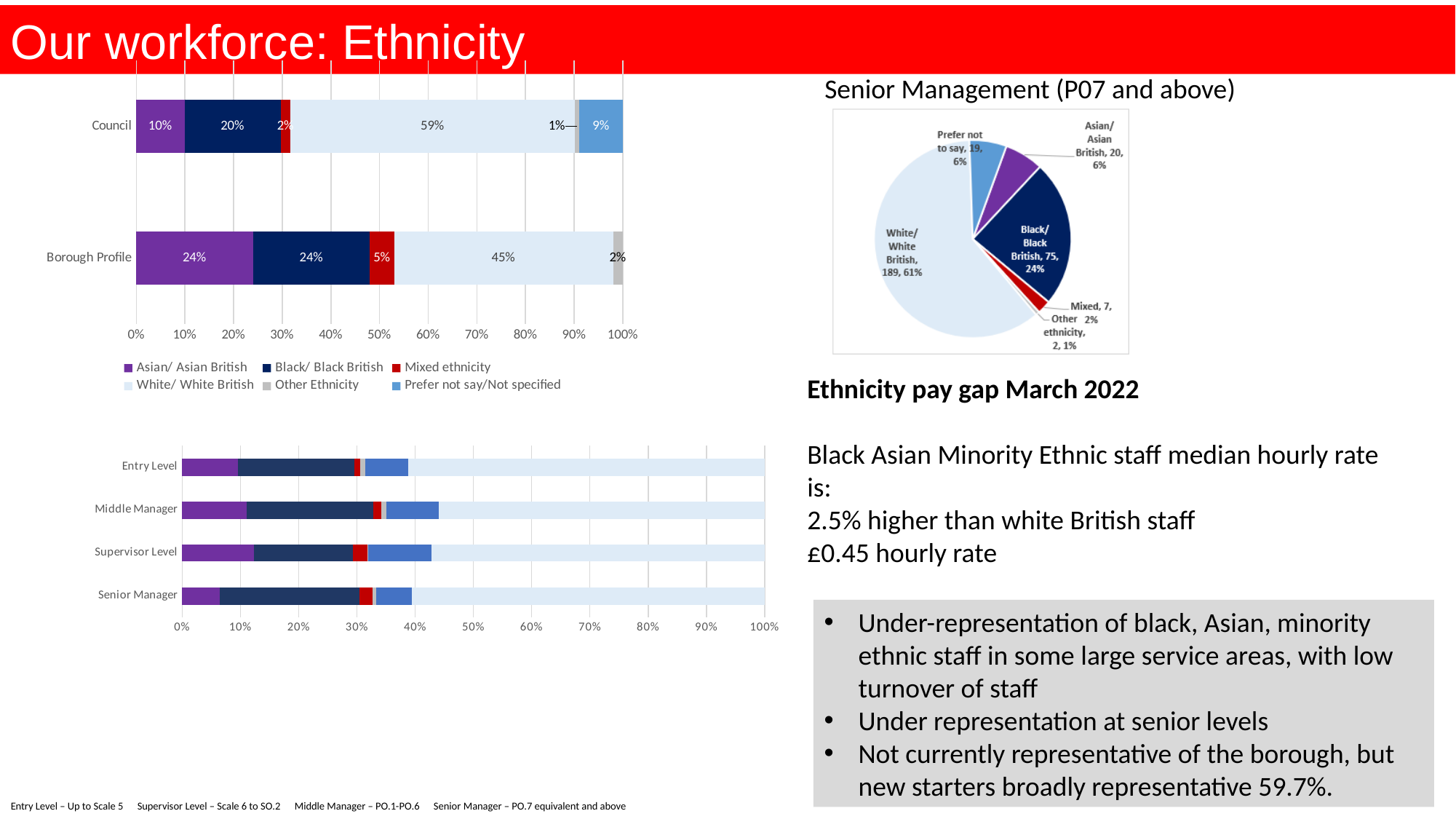
In the Senior Management (P07 and above) pie chart, how many staff are Black/ Black British? 75 In the top-left stacked bar chart, what percentage of the Council workforce is White/ White British? 59% In the top-left stacked bar chart, what is the Prefer not say/Not specified percentage for the Council? 9% In the Senior Management (P07 and above) pie chart, which group is the smallest? Other ethnicity How many series does the legend of the top-left stacked bar chart list? 6 In the top-left stacked bar chart, by how many percentage points does the Council's White/ White British share exceed the Borough Profile's? 14 percentage points In the top-left stacked bar chart, what is the Asian/ Asian British percentage for the Borough Profile? 24% In the Senior Management (P07 and above) pie chart, what share of the pie is White/ White British? 61% What kind of chart is the top-left chart comparing Council and Borough Profile? Stacked bar chart How many job levels are shown in the bottom-left stacked bar chart? 4 In the Senior Management (P07 and above) pie chart, which group is the largest? White/ White British In the top-left stacked bar chart, which has the larger Mixed ethnicity share, Council or Borough Profile? Borough Profile